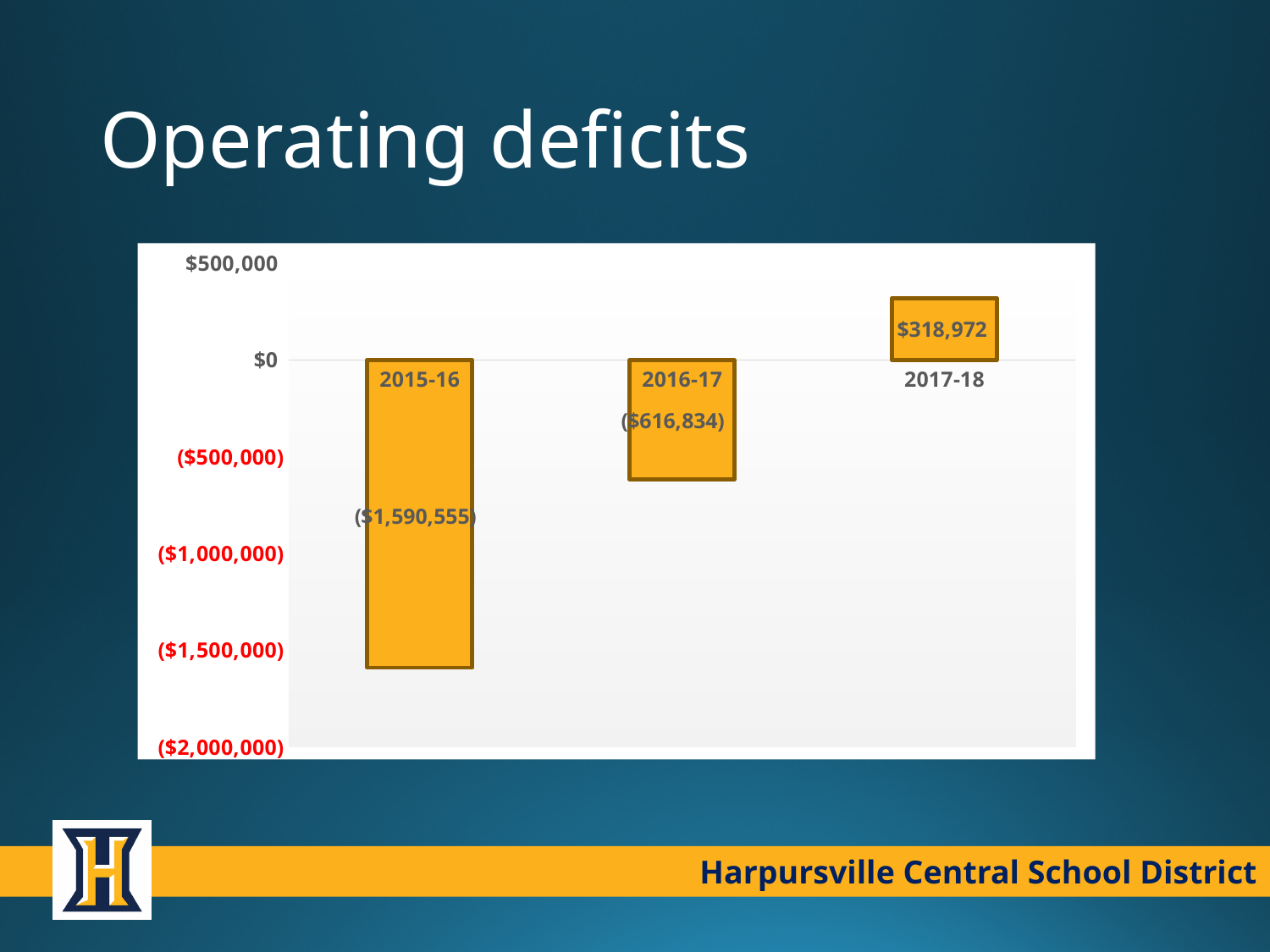
Is the value for 2015-16 greater or less than ($1,500,000)? less By how much did the value increase from 2015-16 to 2016-17? $973,721 Which is larger, the value for 2016-17 or the value for 2017-18? 2017-18 What is the value for 2017-18? $318,972 Do the values rise or fall from 2015-16 to 2017-18? rise Which year has the highest value? 2017-18 What is the value for 2015-16? ($1,590,555) How many years are shown on the chart? 3 Which year has the lowest value? 2015-16 What kind of chart is shown on the slide? bar chart What is the value for 2016-17? ($616,834) By how much did the value increase from 2016-17 to 2017-18? $935,806